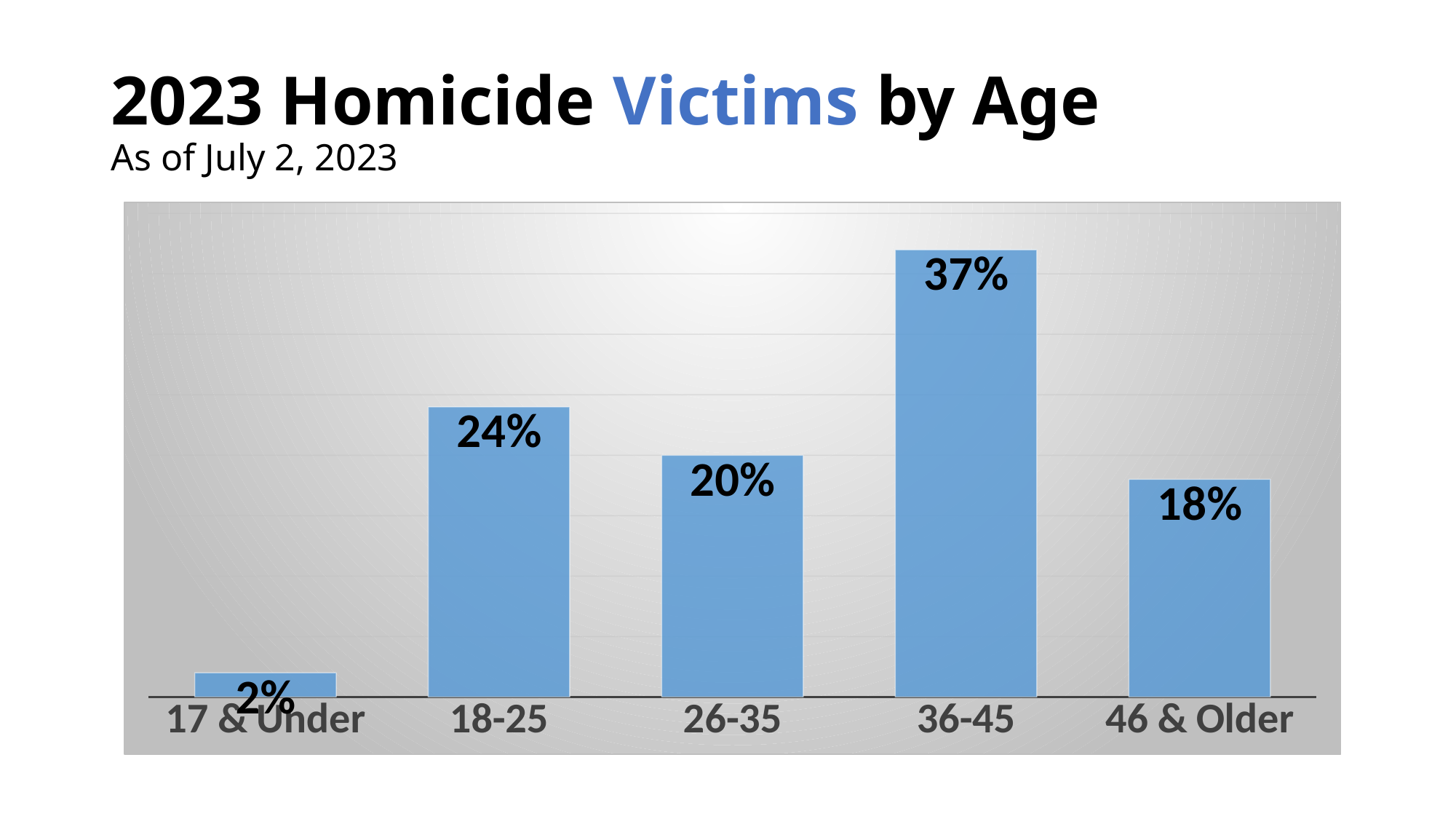
What kind of chart is shown on the slide? Bar chart Which age group has the lowest share of 2023 homicide victims? 17 & Under How many age groups are shown in the chart? 5 What is the difference in percentage points between the 26-35 and 46 & Older age groups? 2 What percentage of 2023 homicide victims were aged 18-25? 24% What is the difference in percentage points between the 36-45 and 18-25 age groups? 13 What percentage of 2023 homicide victims were aged 36-45? 37% What percentage of 2023 homicide victims were 46 & Older? 18% Which age group has a larger share of victims, 18-25 or 26-35? 18-25 What is the title of the slide? 2023 Homicide Victims by Age Which age group has the highest share of 2023 homicide victims? 36-45 What percentage of 2023 homicide victims were 17 & Under? 2%